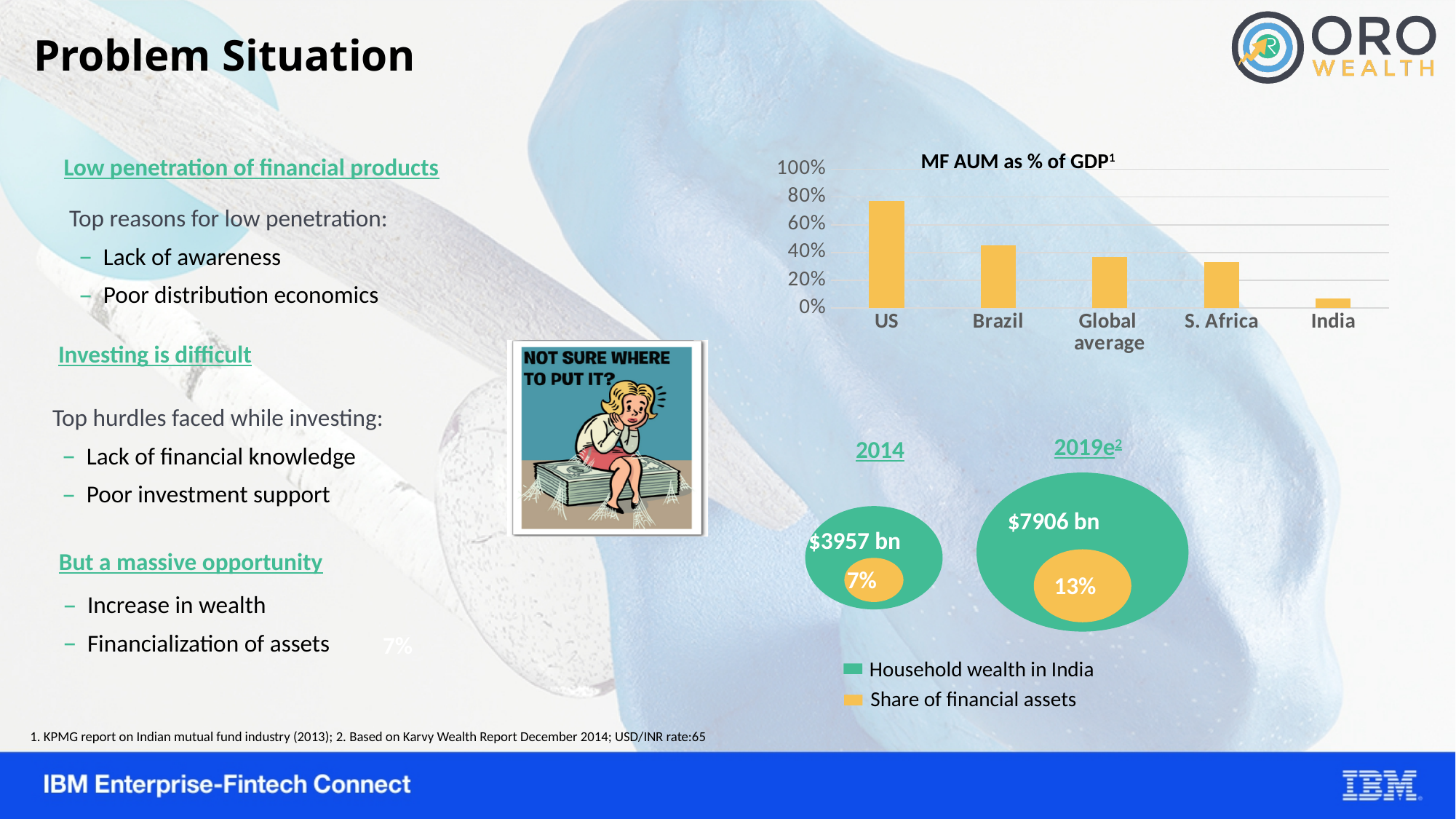
What kind of chart is the 'MF AUM as % of GDP' chart? bar chart In the 'MF AUM as % of GDP' chart, which category has the highest value? US In the bubble diagram at the bottom right, what share of financial assets is shown for 2019e? 13% How many entries does the legend of the bubble diagram at the bottom right list? 2 In the bubble diagram at the bottom right, what is the household wealth in India shown for 2014? $3957 bn How many categories are shown in the 'MF AUM as % of GDP' chart? 5 In the 'MF AUM as % of GDP' chart, which category has the lowest value? India In the 'MF AUM as % of GDP' chart, is the value for Brazil greater or less than 40%? greater In the 'MF AUM as % of GDP' chart, is the value for India greater or less than 20%? less In the 'MF AUM as % of GDP' chart, do the values rise or fall from left to right across the categories? fall In the 'MF AUM as % of GDP' chart, which is larger, the value for Brazil or the value for S. Africa? Brazil In the 'MF AUM as % of GDP' chart, is the value for US greater or less than 60%? greater